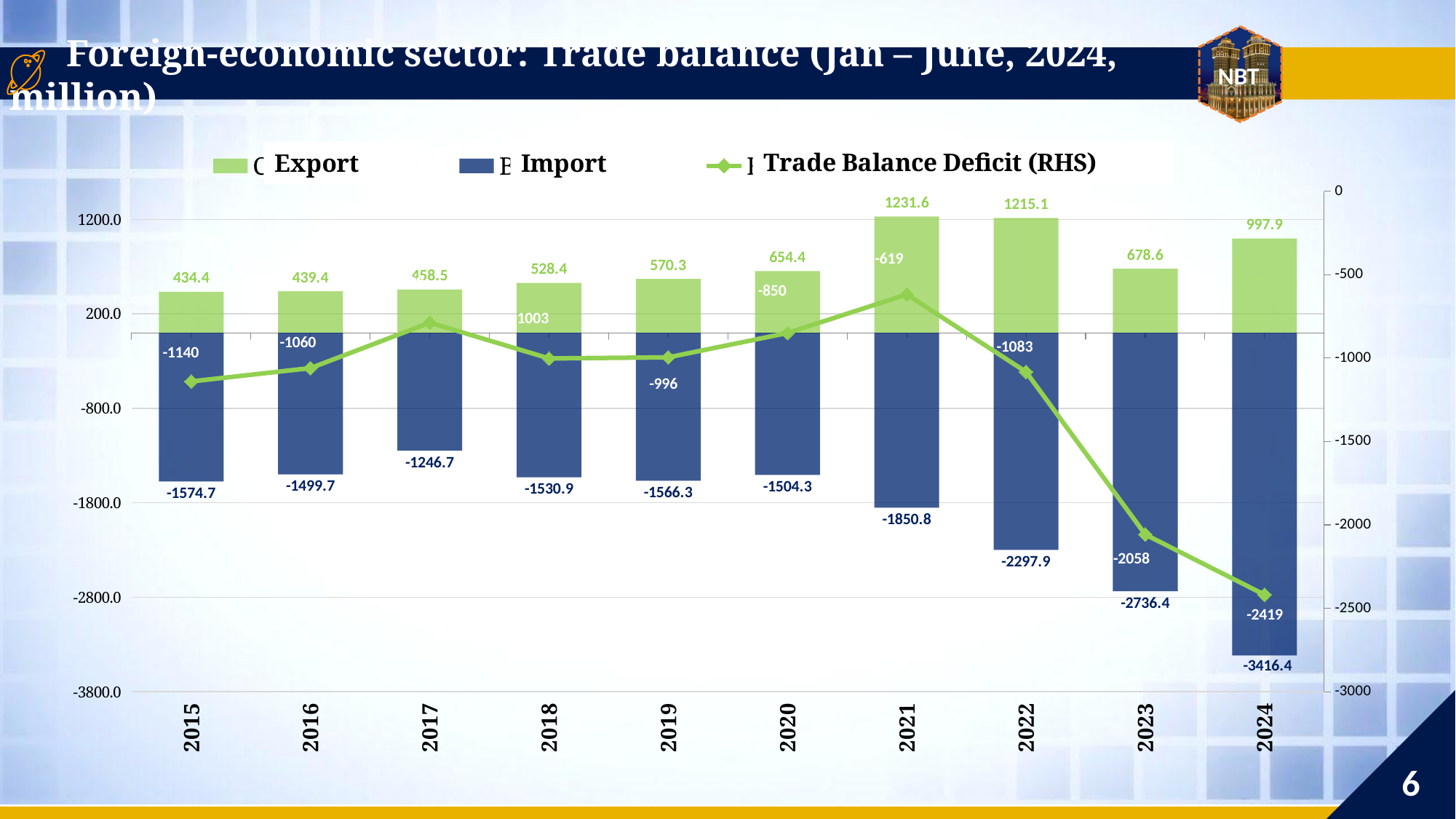
Which year has the larger Import value in absolute terms, 2022 or 2023? 2023 What is the difference between the Export values for 2021 and 2022? 16.5 What is the Trade Balance Deficit (RHS) value for 2024? -2419 What is the Trade Balance Deficit (RHS) value for 2021? -619 What is the Export value for 2024? 997.9 What is the difference between the Export values for 2024 and 2023? 319.3 Which year has the lowest Export value? 2015 How many series does the legend list? 3 Which year has the highest Export value? 2021 Do the Import values become more negative or less negative from 2020 to 2024? more negative How many years are shown on the x axis? 10 What is the Import value for 2024? -3416.4